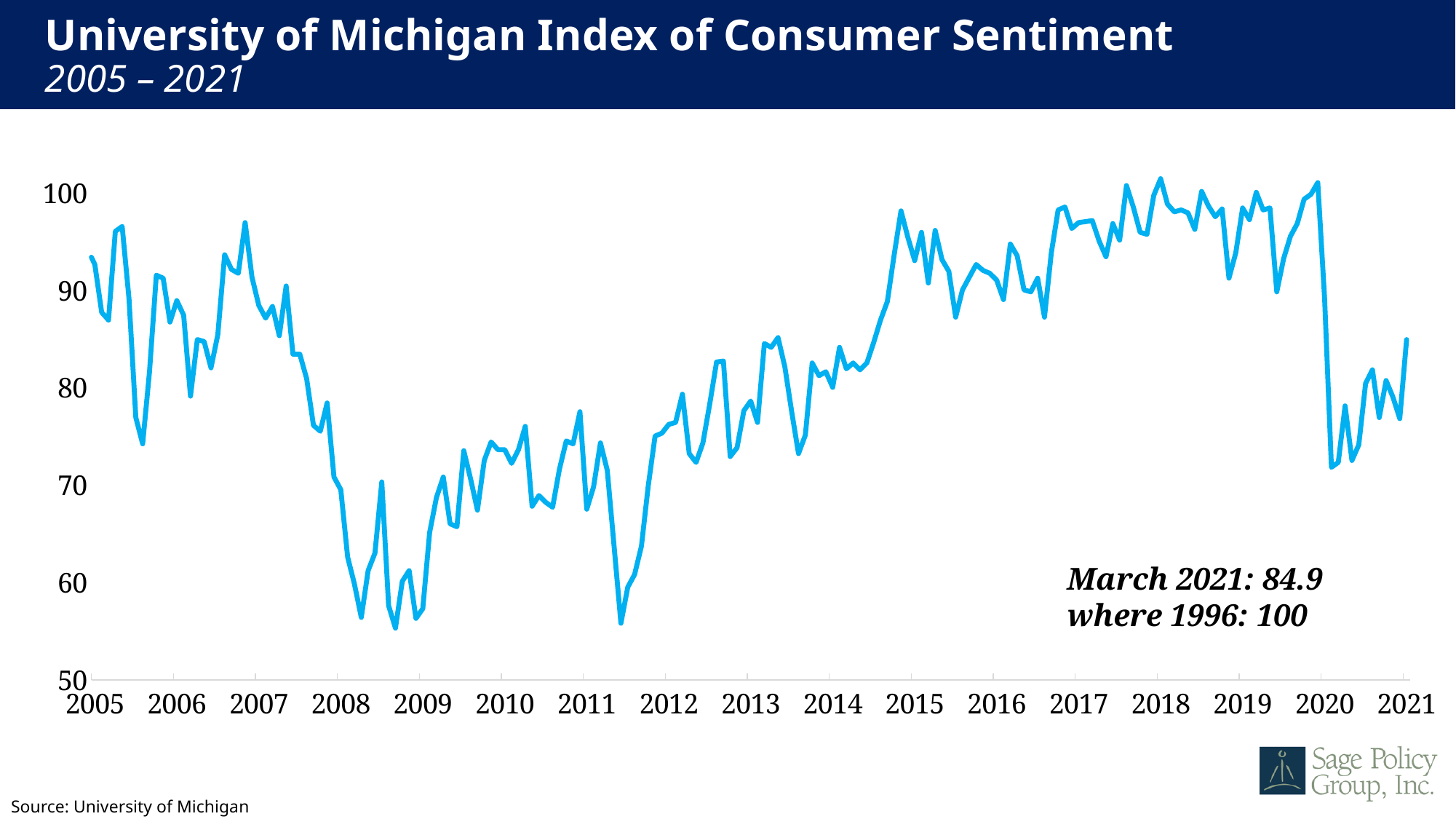
What kind of chart is shown on the slide? line chart Is the lowest value reached in 2020 greater or less than 80? less Is the lowest value reached in 2011 greater or less than 60? less Is the lowest value reached in late 2008 greater or less than 60? less Does the index rise or fall between the start of 2007 and the end of 2008? fall Which is larger, the index value at the start of 2005 or at the start of 2009? start of 2005 What is the title of the chart? University of Michigan Index of Consumer Sentiment What is the value of the University of Michigan Index of Consumer Sentiment for March 2021? 84.9 Which year is the base year where the index equals 100? 1996 How many year labels are shown on the x axis? 17 Does the index generally rise or fall between 2009 and 2018? rise